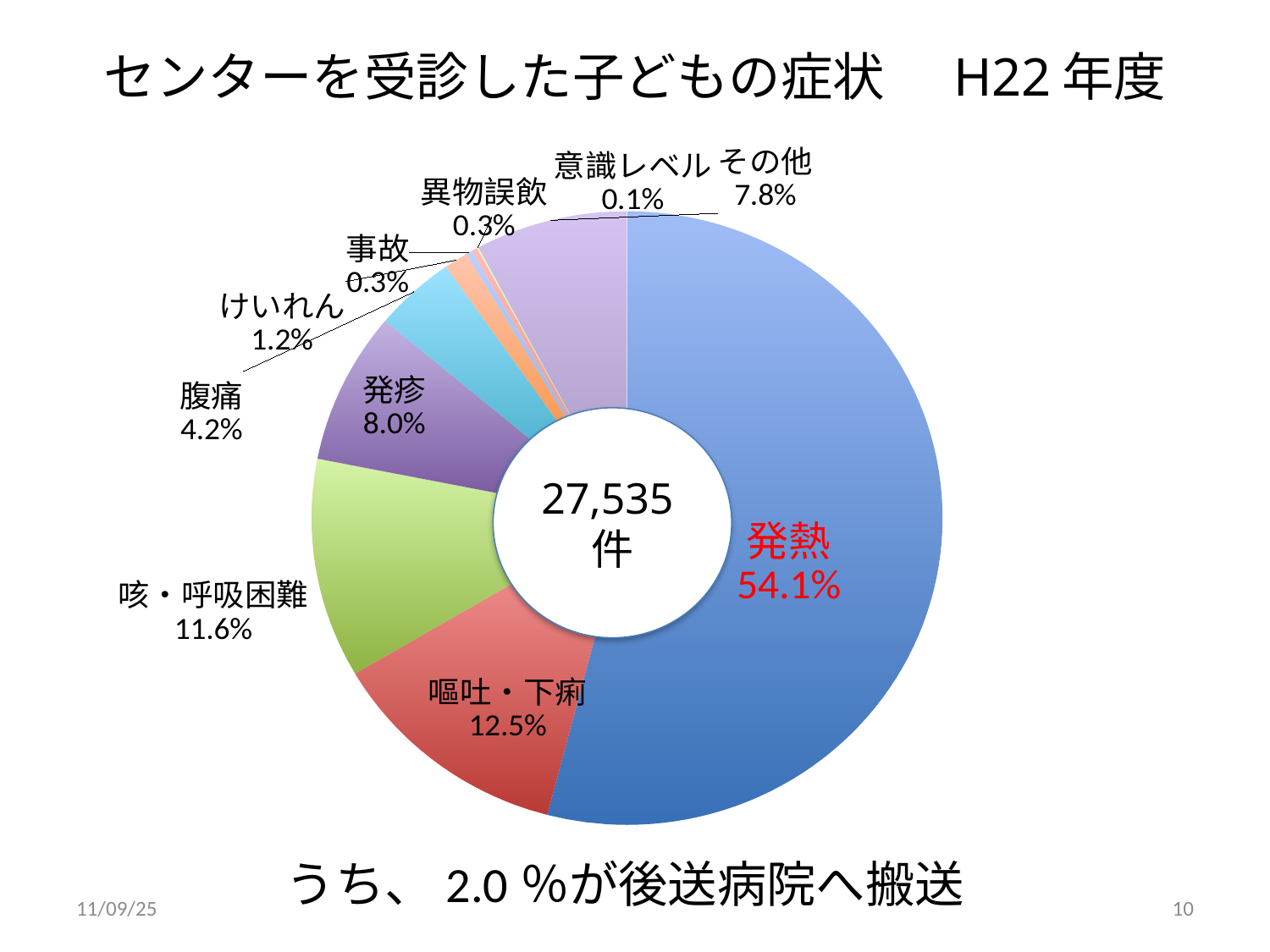
Which category has the smallest share of the chart? 意識レベル Which is larger, the share for 発疹 or the share for その他? 発疹 What kind of chart is shown on the slide? doughnut chart Which category has the largest share of the chart? 発熱 What total number of cases is printed in the centre of the chart? 27,535件 How many percentage points larger is 嘔吐・下痢 than 咳・呼吸困難? 0.9 What is the percentage shown for 嘔吐・下痢? 12.5% What is the percentage shown for 発疹? 8.0% What share of the pie does 発熱 account for? 54.1% What is the percentage shown for 咳・呼吸困難? 11.6% What is the percentage shown for 腹痛? 4.2% How many categories are shown in the chart? 10